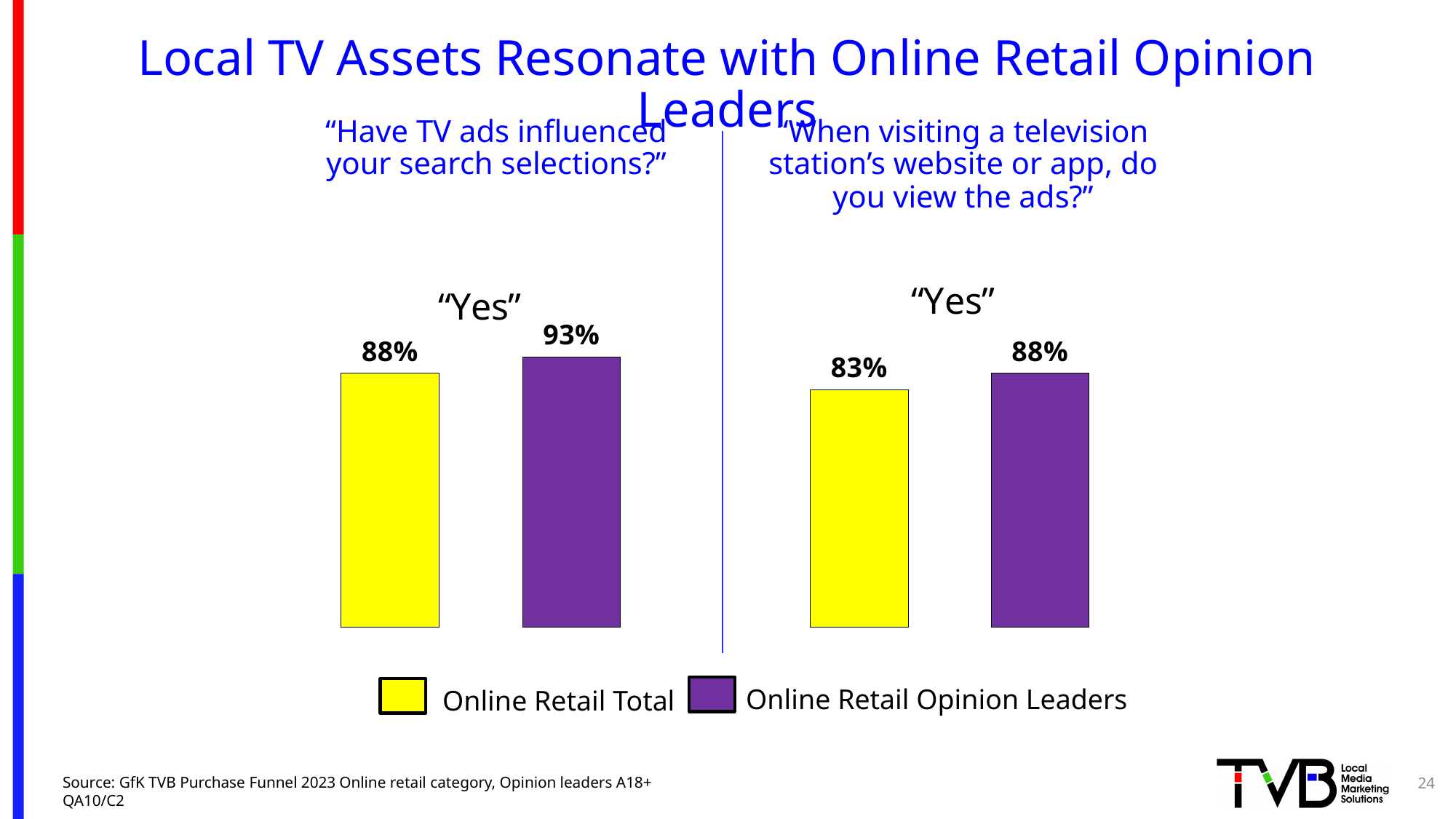
In the left chart ("Have TV ads influenced your search selections?"), what percentage of Online Retail Total answered "Yes"? 88% In the right chart ("When visiting a television station's website or app, do you view the ads?"), what percentage of Online Retail Total answered "Yes"? 83% In the left chart, what is the difference in percentage points between Online Retail Opinion Leaders and Online Retail Total? 5 percentage points In the left chart ("Have TV ads influenced your search selections?"), what percentage of Online Retail Opinion Leaders answered "Yes"? 93% In the right chart ("When visiting a television station's website or app, do you view the ads?"), what percentage of Online Retail Opinion Leaders answered "Yes"? 88% What kind of chart is used on this slide? bar chart In the left chart, which group has the higher "Yes" percentage? Online Retail Opinion Leaders In the right chart, what is the difference in percentage points between Online Retail Opinion Leaders and Online Retail Total? 5 percentage points What colour represents Online Retail Opinion Leaders in the legend? purple Is the Online Retail Total value in the left chart larger or smaller than the Online Retail Total value in the right chart? larger How many series does the legend list? 2 In the right chart, which group has the lower "Yes" percentage? Online Retail Total